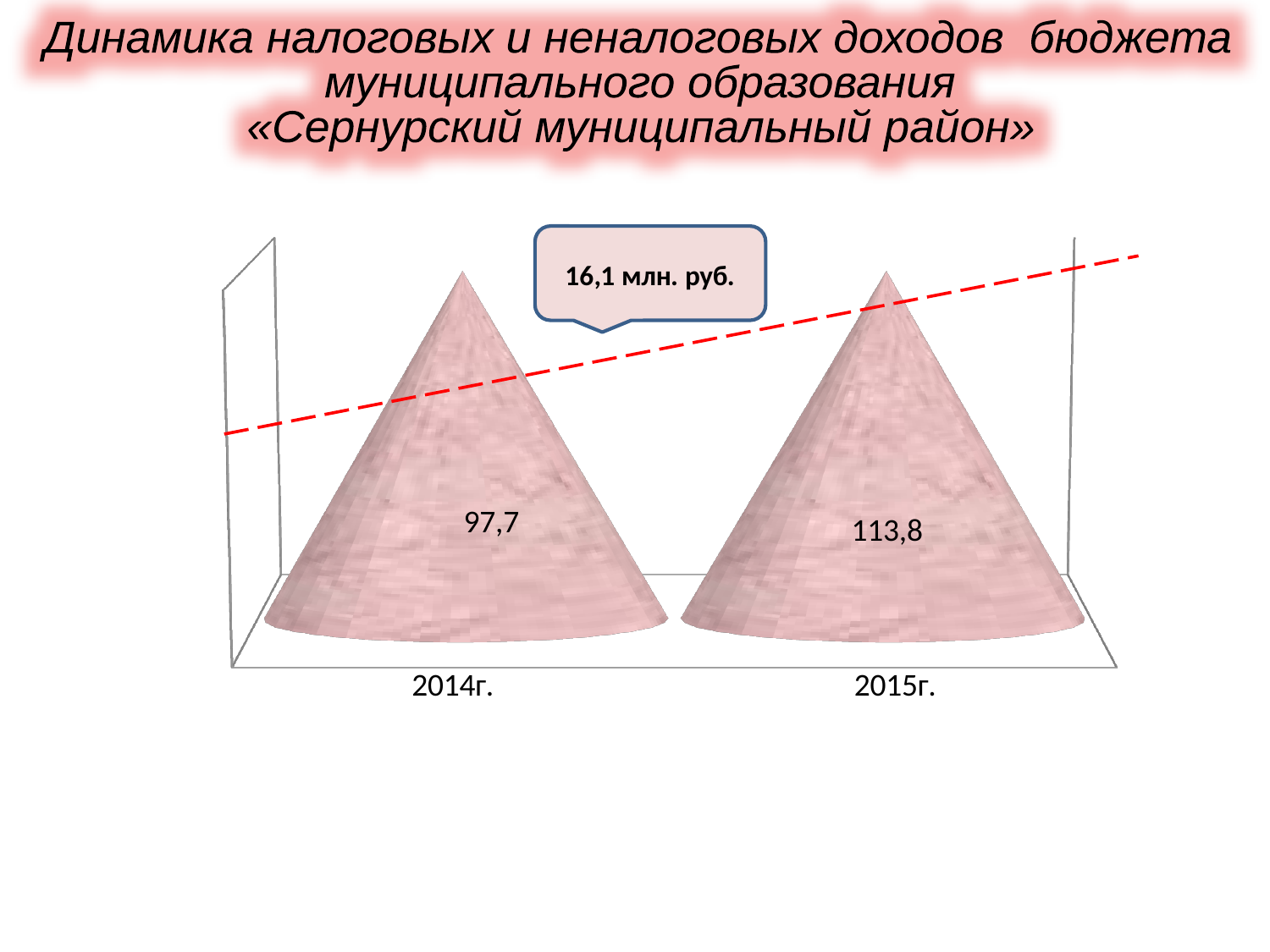
Which is larger, the value for 2014г. or the value for 2015г.? 2015г. Do the values rise or fall from 2014г. to 2015г.? rise Which year has the lowest value? 2014г. What is the value for 2015г.? 113,8 What kind of chart is shown on the slide? bar chart Which year has the highest value? 2015г. What is the value for 2014г.? 97,7 What value is shown in the callout above the chart? 16,1 млн. руб. What is the title of the slide? Динамика налоговых и неналоговых доходов бюджета муниципального образования «Сернурский муниципальный район» How many categories are shown on the chart? 2 What is the difference between the values for 2015г. and 2014г.? 16,1